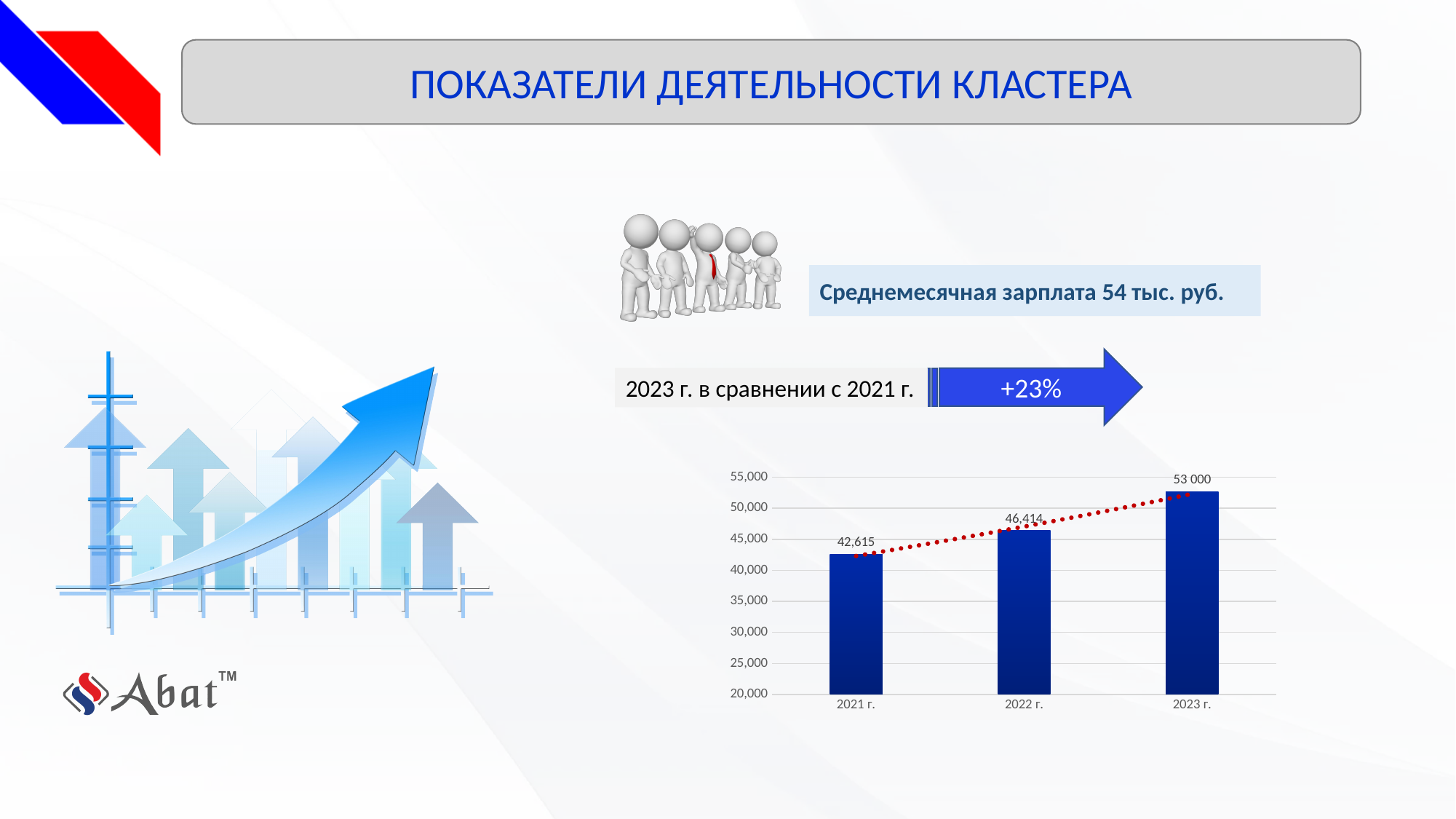
What is the value for 2023 г. in the bar chart? 53 000 Do the values in the bar chart rise or fall from 2021 г. to 2023 г.? rise What is the value for 2021 г. in the bar chart? 42,615 Which is larger in the bar chart, the value for 2022 г. or the value for 2023 г.? 2023 г. Which year has the highest value in the bar chart? 2023 г. How many bars are shown in the bar chart? 3 What is the difference between the values for 2022 г. and 2021 г. in the bar chart? 3,799 What is the difference between the values for 2023 г. and 2021 г. in the bar chart? 10,385 What is the value for 2022 г. in the bar chart? 46,414 Is the value for 2022 г. in the bar chart greater or less than 45,000? greater What kind of chart is shown on the slide? bar chart Which year has the lowest value in the bar chart? 2021 г.